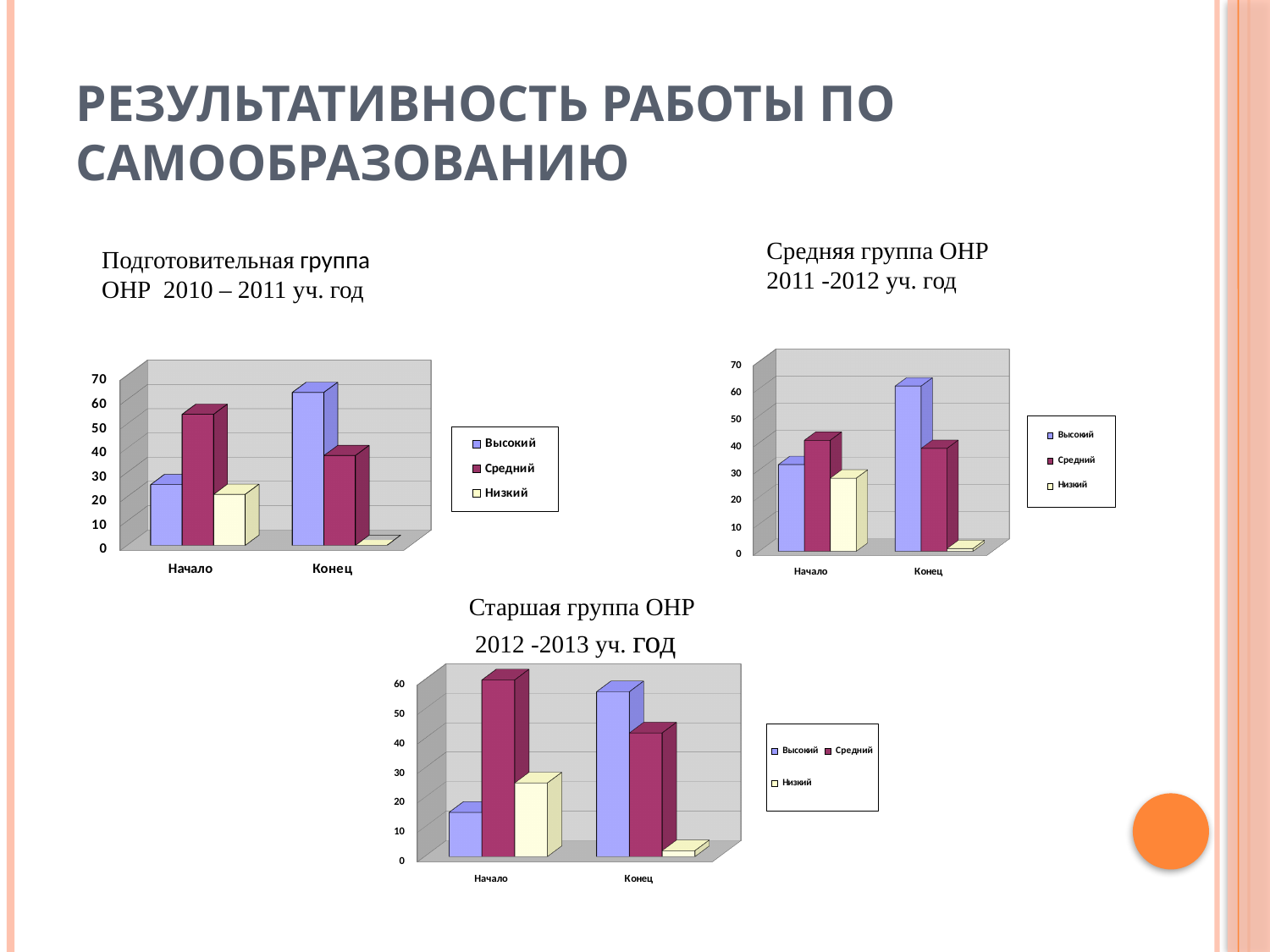
In the chart titled 'Подготовительная группа ОНР 2010 – 2011 уч. год', which series has the tallest bar at 'Конец'? Высокий In the chart titled 'Старшая группа ОНР 2012 -2013 уч. год', is the value for 'Высокий' at 'Начало' greater or less than 20? less In the chart titled 'Подготовительная группа ОНР 2010 – 2011 уч. год', which series has the tallest bar at 'Начало'? Средний In the chart titled 'Средняя группа ОНР 2011 -2012 уч. год', which is larger at 'Начало': 'Высокий' or 'Средний'? Средний In the chart titled 'Средняя группа ОНР 2011 -2012 уч. год', how many categories are shown on the x axis? 2 In the chart titled 'Средняя группа ОНР 2011 -2012 уч. год', is the value for 'Высокий' at 'Конец' greater or less than 50? greater In the chart titled 'Средняя группа ОНР 2011 -2012 уч. год', which series has the lowest bar at 'Конец'? Низкий In the chart titled 'Старшая группа ОНР 2012 -2013 уч. год', does the value for 'Высокий' rise or fall from 'Начало' to 'Конец'? rise In the chart titled 'Подготовительная группа ОНР 2010 – 2011 уч. год', is the value for 'Высокий' at 'Конец' greater or less than 50? greater In the chart titled 'Подготовительная группа ОНР 2010 – 2011 уч. год', how many series does the legend list? 3 In the chart titled 'Старшая группа ОНР 2012 -2013 уч. год', which series has the tallest bar at 'Начало'? Средний In the chart titled 'Подготовительная группа ОНР 2010 – 2011 уч. год', what kind of chart is shown? bar chart